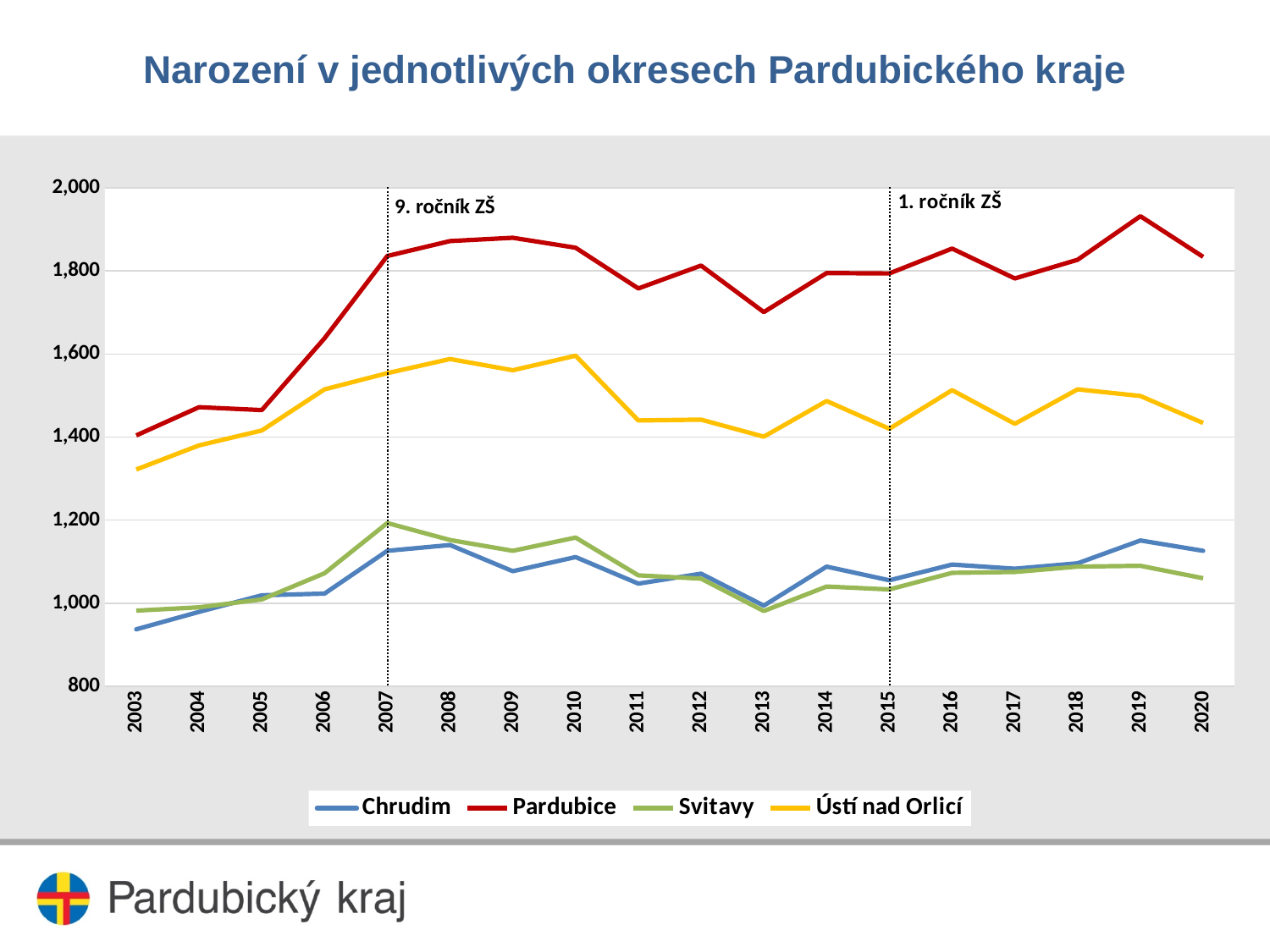
What kind of chart is shown on the slide? line chart Is the value for Pardubice in 2019 greater or less than 1,800? greater Which is larger in 2007, the value for Chrudim or the value for Svitavy? Svitavy In which year does the Chrudim series have its lowest value? 2003 Which series has the highest values throughout the chart? Pardubice How many series does the legend list? 4 Is the value for Chrudim in 2003 greater or less than 1,000? less Does the Pardubice series rise or fall between 2005 and 2007? rise What label is attached to the vertical dotted line at 2015? 1. ročník ZŠ In which year does the Pardubice series reach its highest value? 2019 How many years are plotted along the x axis? 18 Is the value for Ústí nad Orlicí in 2003 greater or less than 1,400? less